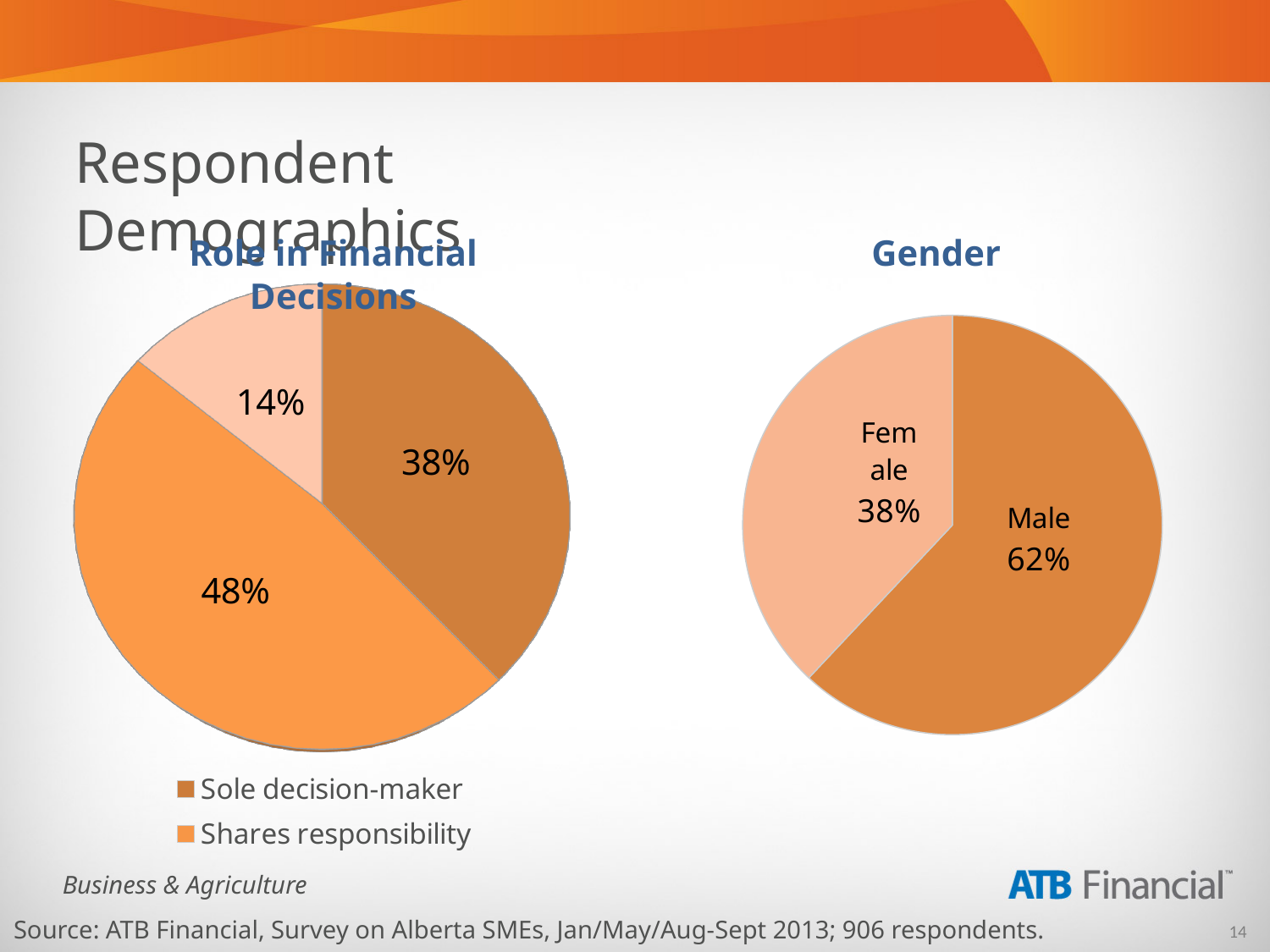
In the Gender chart, what is the difference between the Male and Female shares? 24% What type of chart is the Gender chart? Pie chart In the Role in Financial Decisions chart, what is the difference between the Shares responsibility and Sole decision-maker shares? 10% In the Gender chart, what percentage of respondents are male? 62% In the Role in Financial Decisions chart, what percentage of respondents share responsibility? 48% In the Gender chart, what percentage of respondents are female? 38% In the Role in Financial Decisions chart, what is the value of the smallest slice? 14% In the Gender chart, how many slices does the pie have? 2 In the Role in Financial Decisions chart, which category has the largest share? Shares responsibility In the Role in Financial Decisions chart, what percentage of respondents are sole decision-makers? 38% In the Gender chart, which gender has the larger share? Male In the Role in Financial Decisions chart, how many slices does the pie have? 3